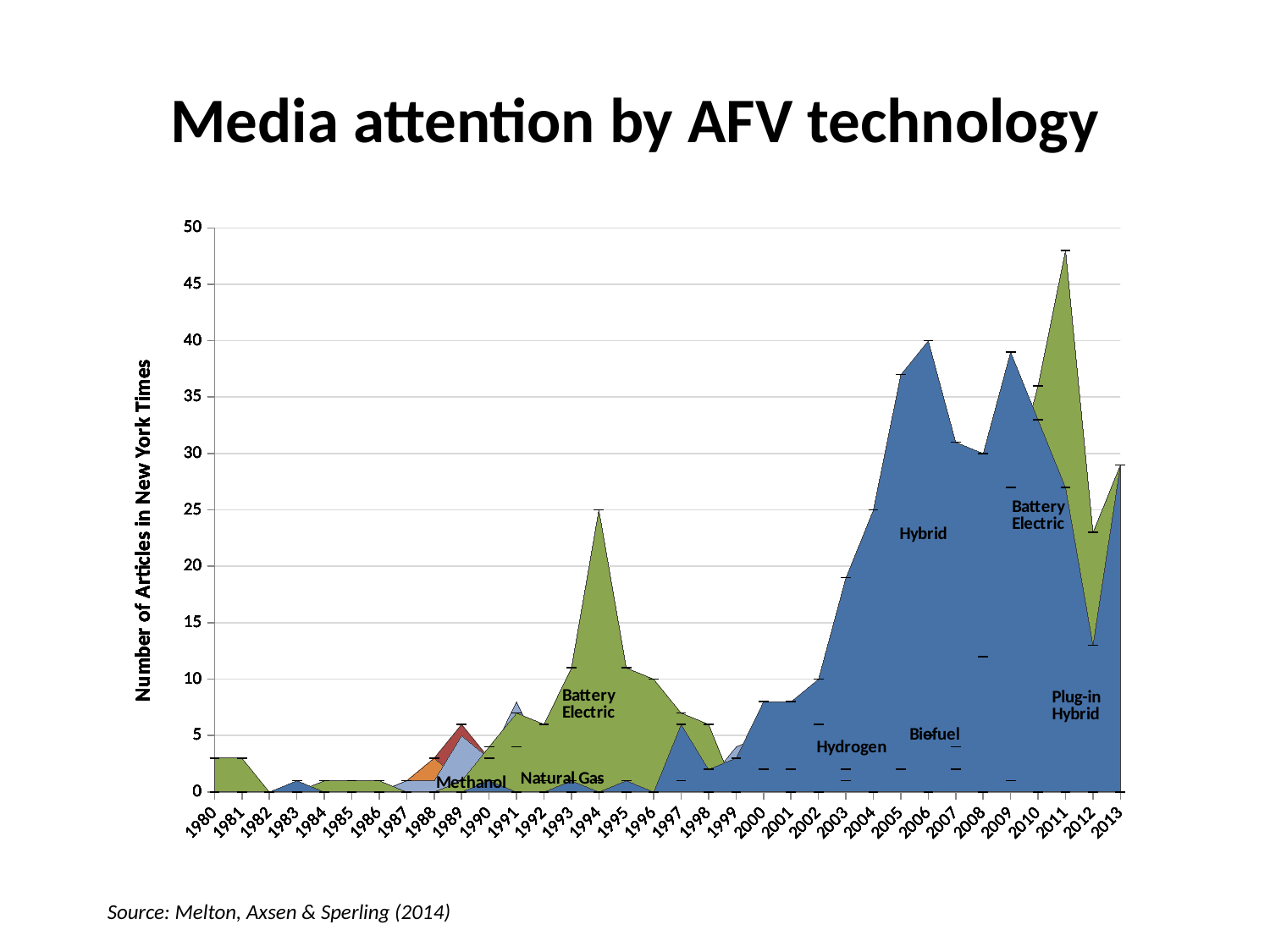
What is the label of the vertical axis? Number of Articles in New York Times Which year has a higher total number of articles, 1994 or 1995? 1994 Is the total number of articles in 1982 greater or less than 5? less What is the title of the chart? Media attention by AFV technology How many years are shown along the x axis? 34 Is the total number of articles in 2006 greater or less than 35? greater Is the total number of articles in 2011 greater or less than 45? greater Does the total number of articles rise or fall from 2002 to 2006? rise What type of chart is shown on the slide? Area chart In which year is the total number of articles highest? 2011 Which year has a higher total number of articles, 2004 or 2005? 2005